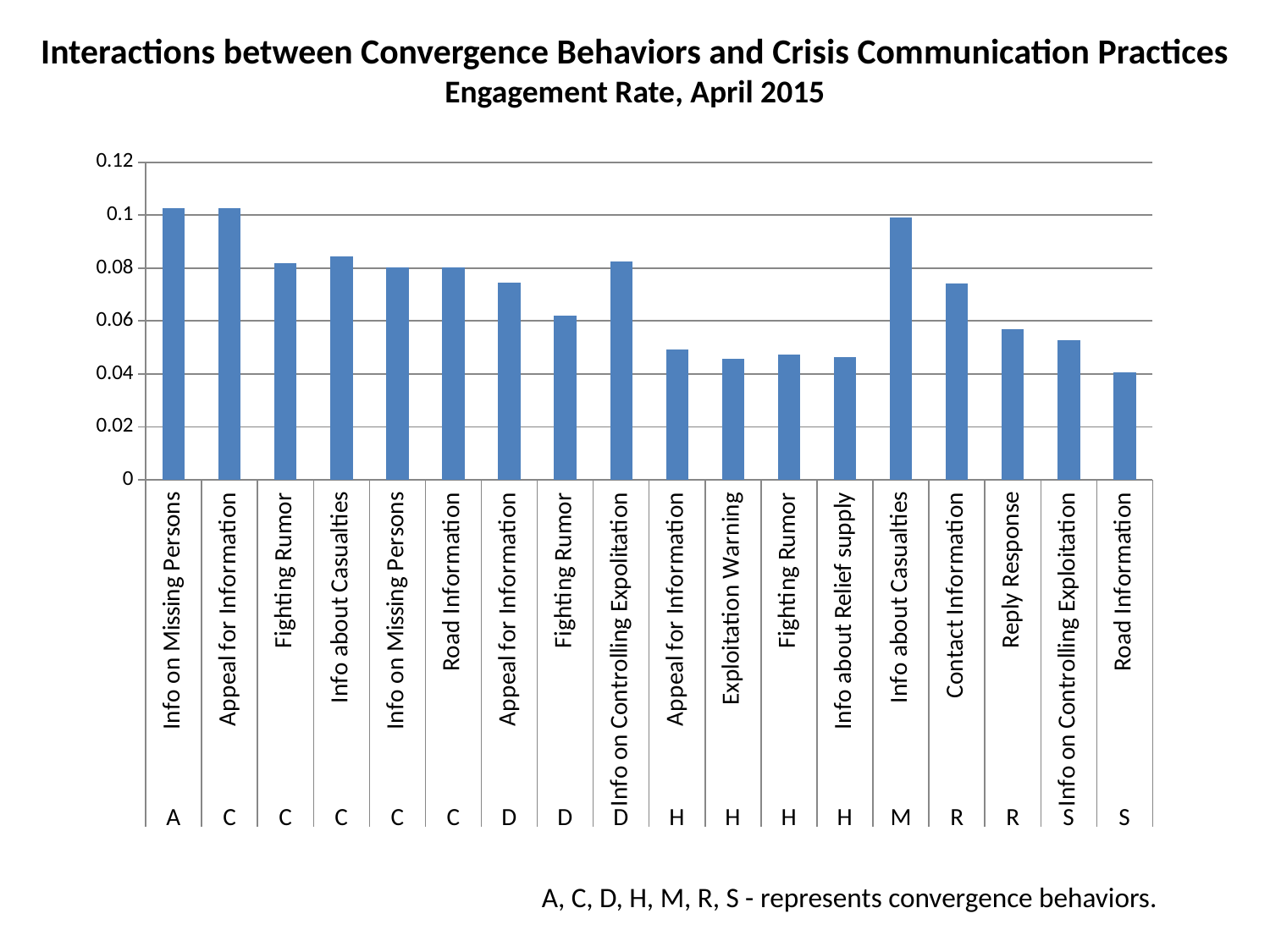
Is the engagement rate for Contact Information under group R greater or less than 0.08? less What kind of chart is shown on the slide? bar chart Which has the higher engagement rate: Info on Controlling Exploitation under group D or Info on Controlling Exploitation under group S? Info on Controlling Exploitation under group D Is the engagement rate for Exploitation Warning under group H greater or less than 0.06? less Is the engagement rate for Info about Casualties under group M greater or less than 0.08? greater How many convergence behavior groups (letters) are shown along the x axis? 7 How many bars are plotted in the chart? 18 Which has the higher engagement rate: Fighting Rumor under group C or Fighting Rumor under group H? Fighting Rumor under group C Which has the higher engagement rate: Info about Casualties under group M or Contact Information under group R? Info about Casualties under group M What is the subtitle of the chart? Engagement Rate, April 2015